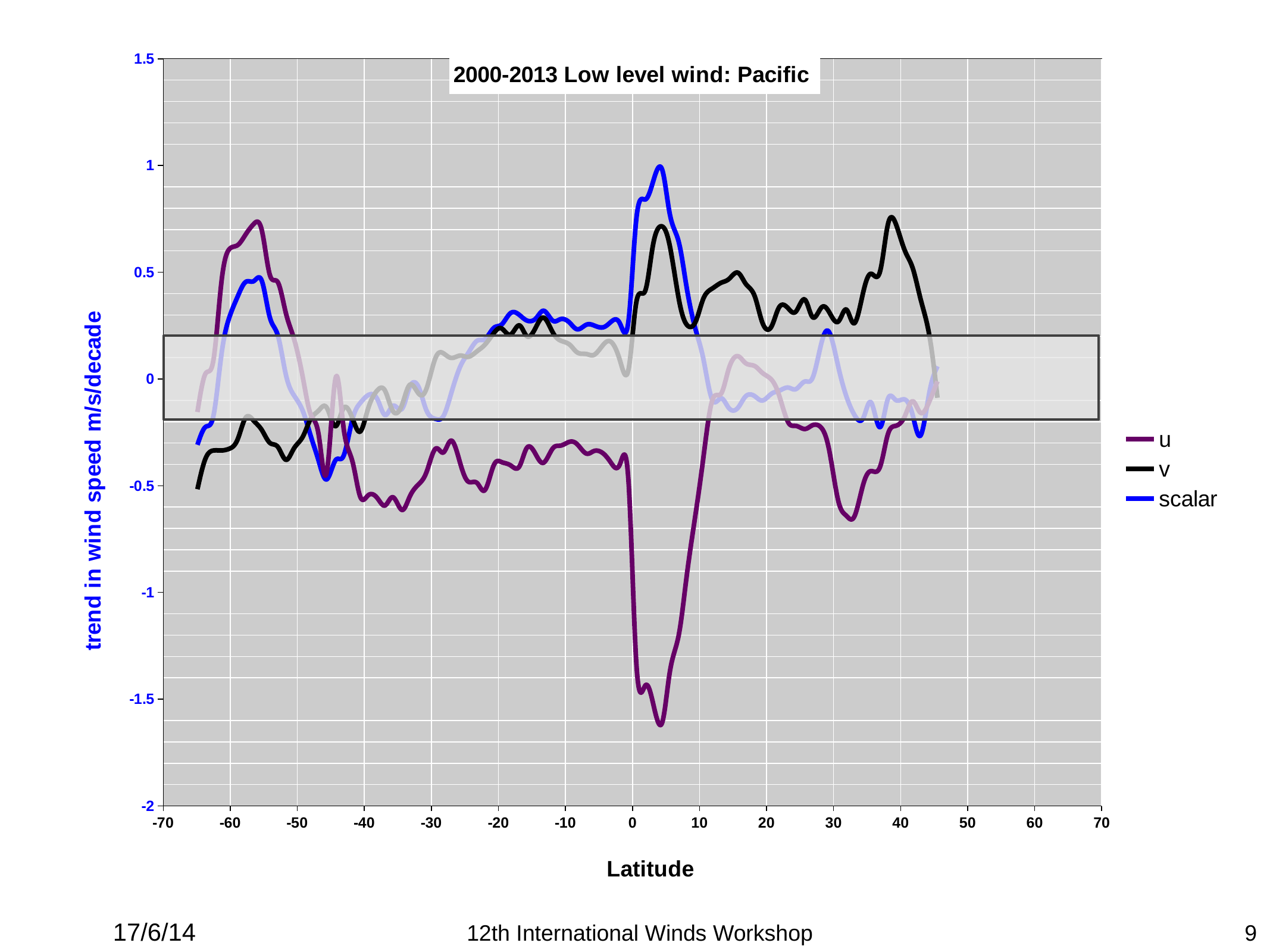
How many series does the legend list? 3 At latitude 5, which series has the higher value, u or scalar? scalar Does the u series rise or fall between latitude 0 and latitude 5? fall Is the value of the v series at latitude 40 greater or less than 0.5? greater Is the value of the u series at latitude 5 greater or less than -1? less What kind of chart is shown on the slide? line chart What is the title of the chart? 2000-2013 Low level wind: Pacific Is the value of the u series at latitude -57 greater or less than 0.5? greater Which series reaches the lowest value anywhere on the chart? u Which series reaches the highest value anywhere on the chart? scalar What is the label of the x axis? Latitude